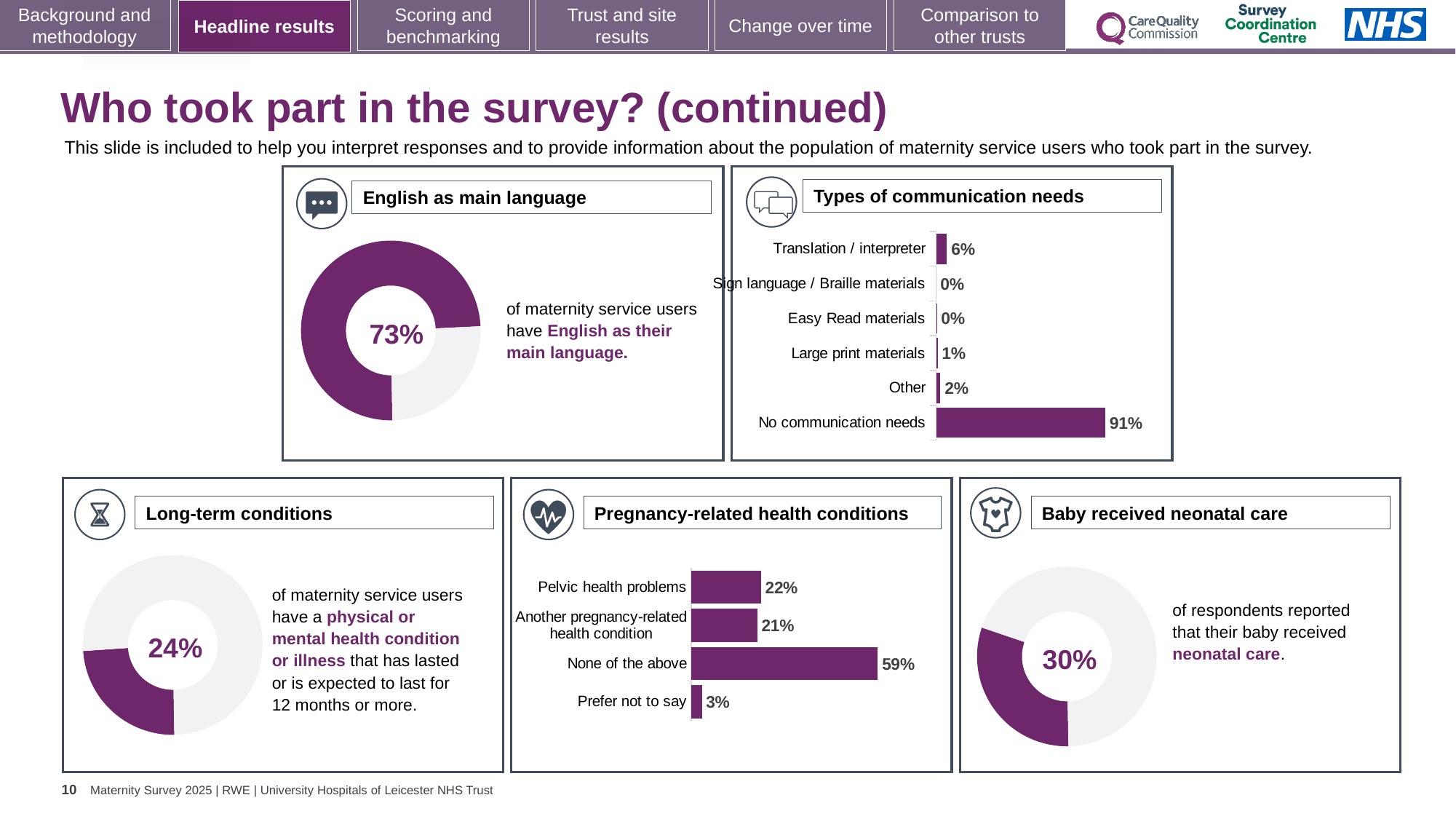
In the 'Types of communication needs' chart, what is the difference between No communication needs and Translation / interpreter? 85% In the 'Pregnancy-related health conditions' chart, which category has the lowest value? Prefer not to say In the 'Baby received neonatal care' chart, what percentage of respondents reported that their baby received neonatal care? 30% In the 'English as main language' chart, what percentage of maternity service users have English as their main language? 73% In the 'Long-term conditions' chart, what percentage of maternity service users have a physical or mental health condition or illness? 24% In the 'Pregnancy-related health conditions' chart, which is larger: None of the above or Another pregnancy-related health condition? None of the above In the 'Types of communication needs' chart, how many categories are shown? 6 In the 'Types of communication needs' chart, what is the value for Translation / interpreter? 6% What kind of chart is the 'Types of communication needs' chart? Bar chart In the 'Types of communication needs' chart, which category has the highest value? No communication needs In the 'Pregnancy-related health conditions' chart, what is the value for Pelvic health problems? 22% In the 'Types of communication needs' chart, what is the value for Large print materials? 1%